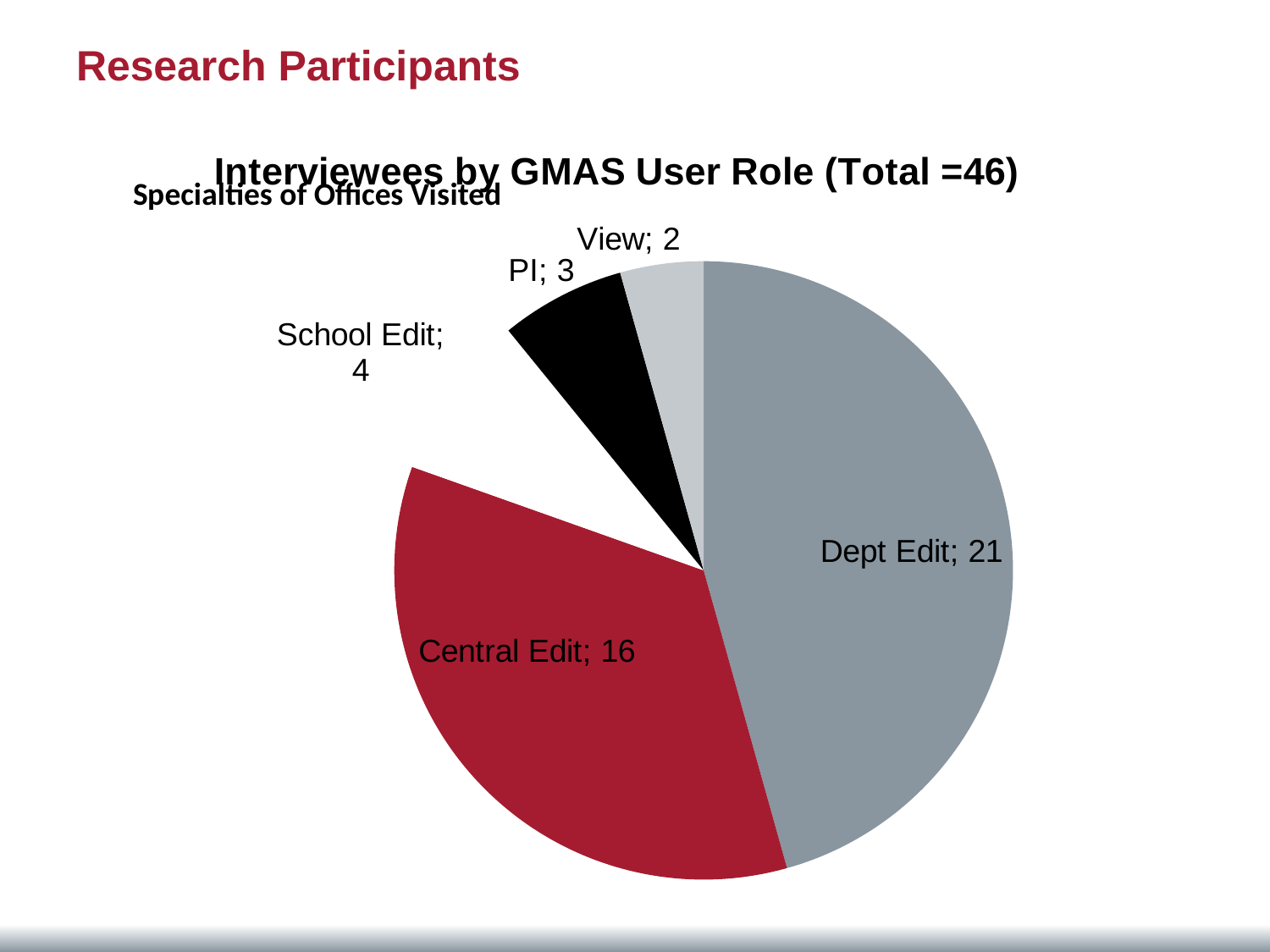
Which user role has the largest slice of the pie? Dept Edit What is the value for Central Edit? 16 How many interviewees are in the Dept Edit role? 21 What is the value for View? 2 How many user role categories are shown in the pie chart? 5 Which user role has the smallest slice of the pie? View What is the value for School Edit? 4 What is the difference between the Dept Edit and Central Edit values? 5 How many interviewees are in the PI role? 3 Which is larger, the value for Central Edit or the value for School Edit? Central Edit What is the total number of interviewees shown in the chart title? 46 What kind of chart is shown on the slide? pie chart